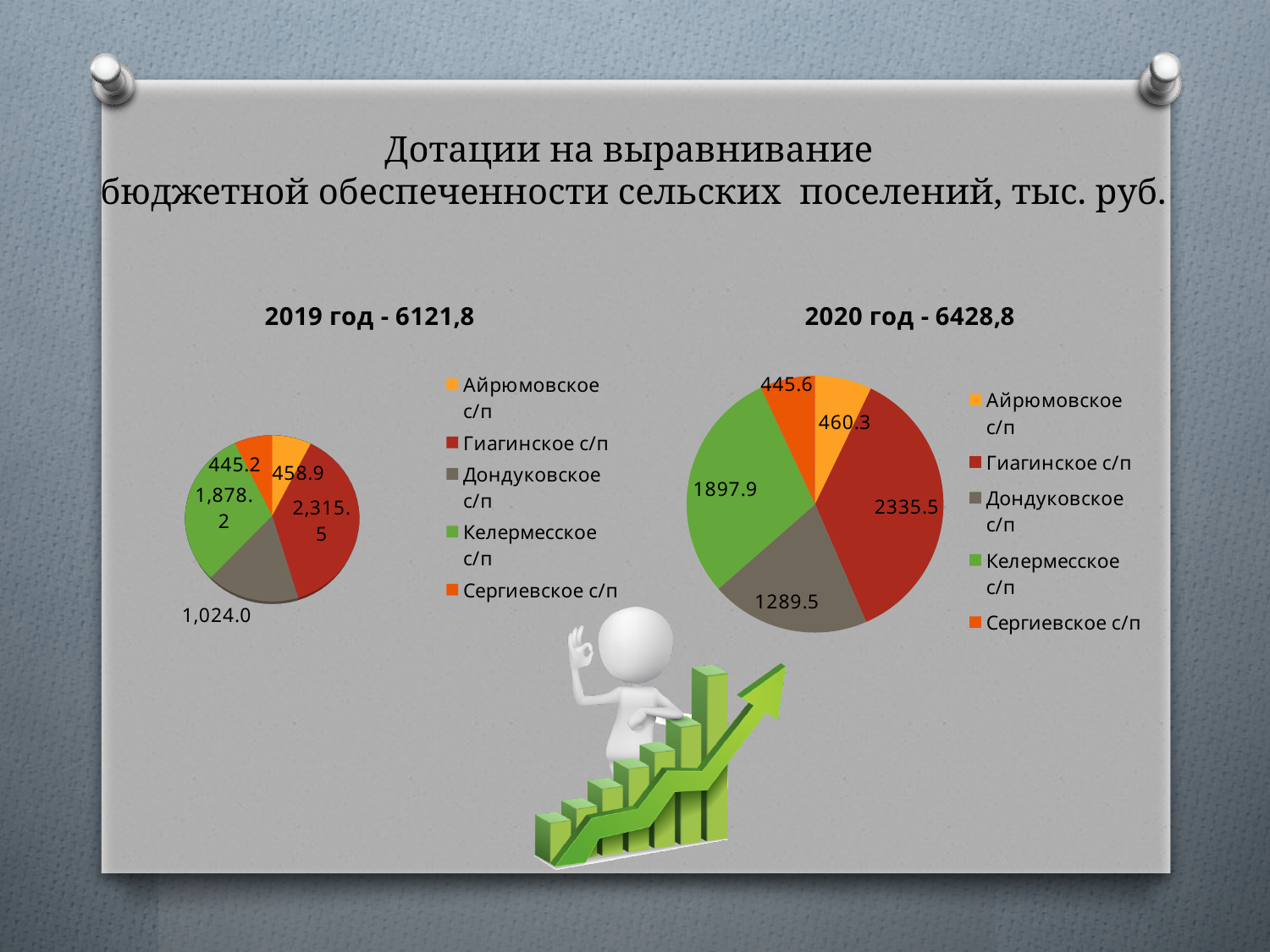
In the 2019 год chart, what is the value for Гиагинское с/п? 2,315.5 In the 2019 год chart, which settlement has the smallest slice? Сергиевское с/п In the 2020 год chart, which settlement has the largest slice? Гиагинское с/п In the 2019 год chart, which is larger: Дондуковское с/п or Келермесское с/п? Келермесское с/п What total is shown in the title of the 2020 год chart? 6428,8 In the 2020 год chart, what is the value for Келермесское с/п? 1897.9 In the 2019 год chart, what is the value for Дондуковское с/п? 1,024.0 In the 2020 год chart, what is the difference between Гиагинское с/п and Келермесское с/п? 437.6 What type of charts are shown on the slide? Pie charts How many entries does the legend of the 2019 год chart list? 5 How many slices does the 2020 год pie chart have? 5 In the 2020 год chart, what is the value for Сергиевское с/п? 445.6